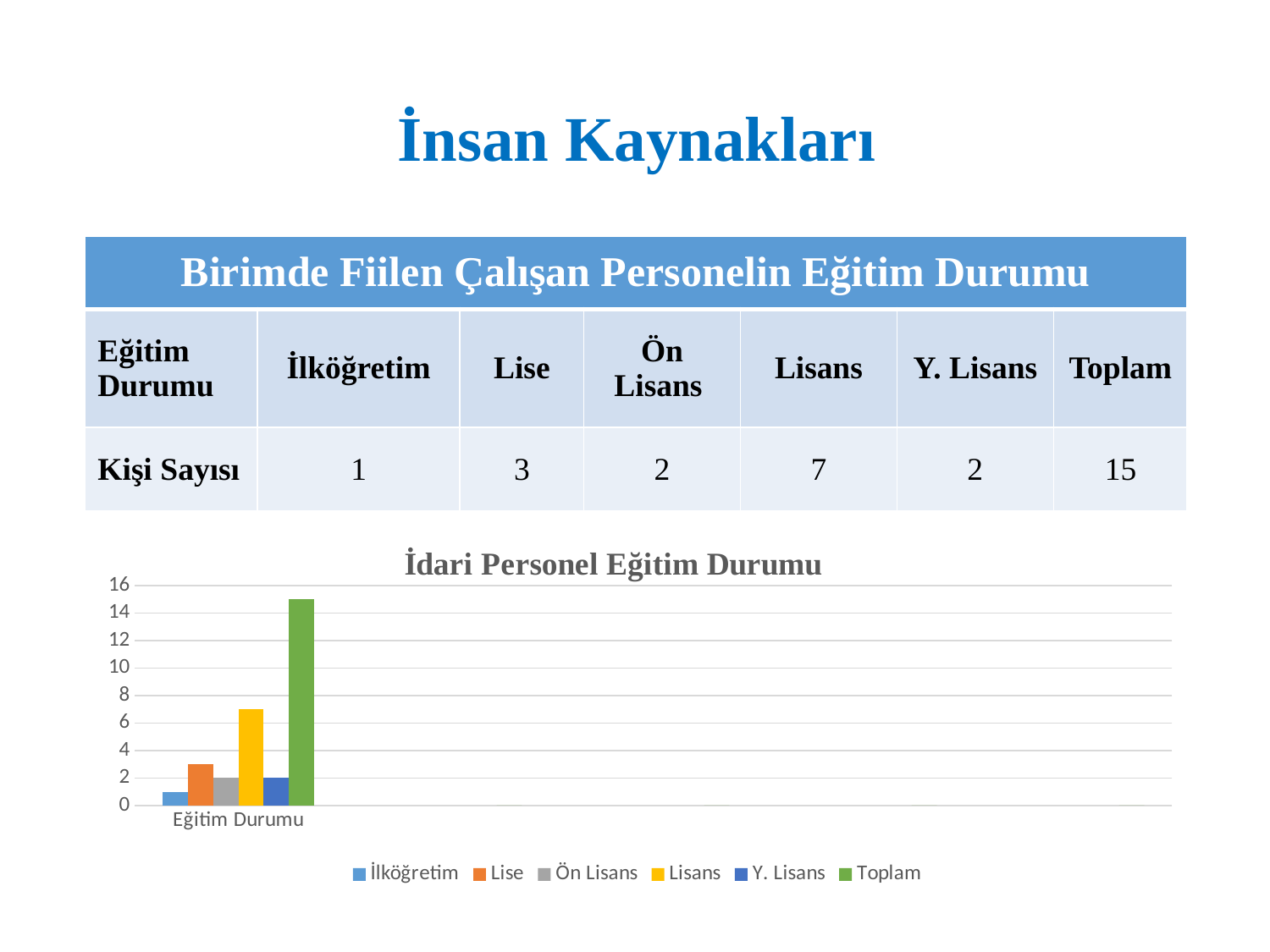
Which series has the shortest bar in the chart? İlköğretim What is the value for Toplam? 15 What is the title of the chart? İdari Personel Eğitim Durumu Which is larger, the value for Lise or the value for Lisans? Lisans What is the value for Lise? 3 What is the value for Lisans? 7 What kind of chart is shown on the slide? bar chart Is the value for Toplam greater or less than 14? greater Which series has the tallest bar in the chart? Toplam How many series does the chart legend list? 6 What is the difference between the value for Lisans and the value for Lise? 4 Is the value for Lisans greater or less than 8? less